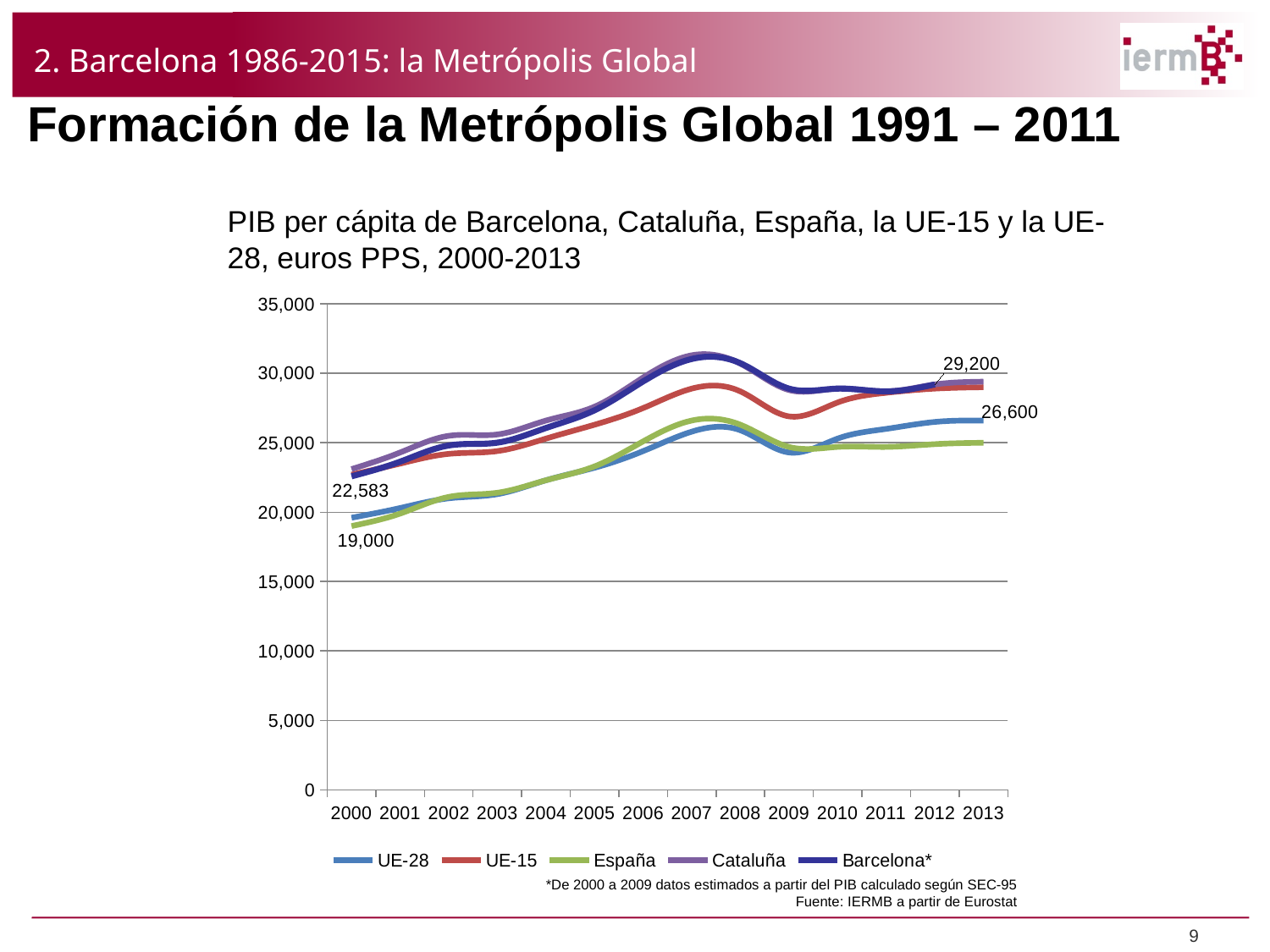
Is the value for Barcelona* in 2007 greater or less than 30,000? greater How many years are shown on the x axis? 14 What is the lowest data label value printed on the chart? 19,000 Is the value for UE-28 in 2009 greater or less than 25,000? less Which series has the lowest value in 2000? España What is the data label shown for España in 2000? 19,000 What is the highest data label value printed on the chart? 29,200 Does the UE-28 series rise or fall from 2000 to 2007? rise How many series does the legend list? 5 What is the difference between the data labels 29,200 and 26,600 shown at 2013? 2,600 What kind of chart is shown on the slide? line chart What is the data label shown for UE-28 in 2013? 26,600